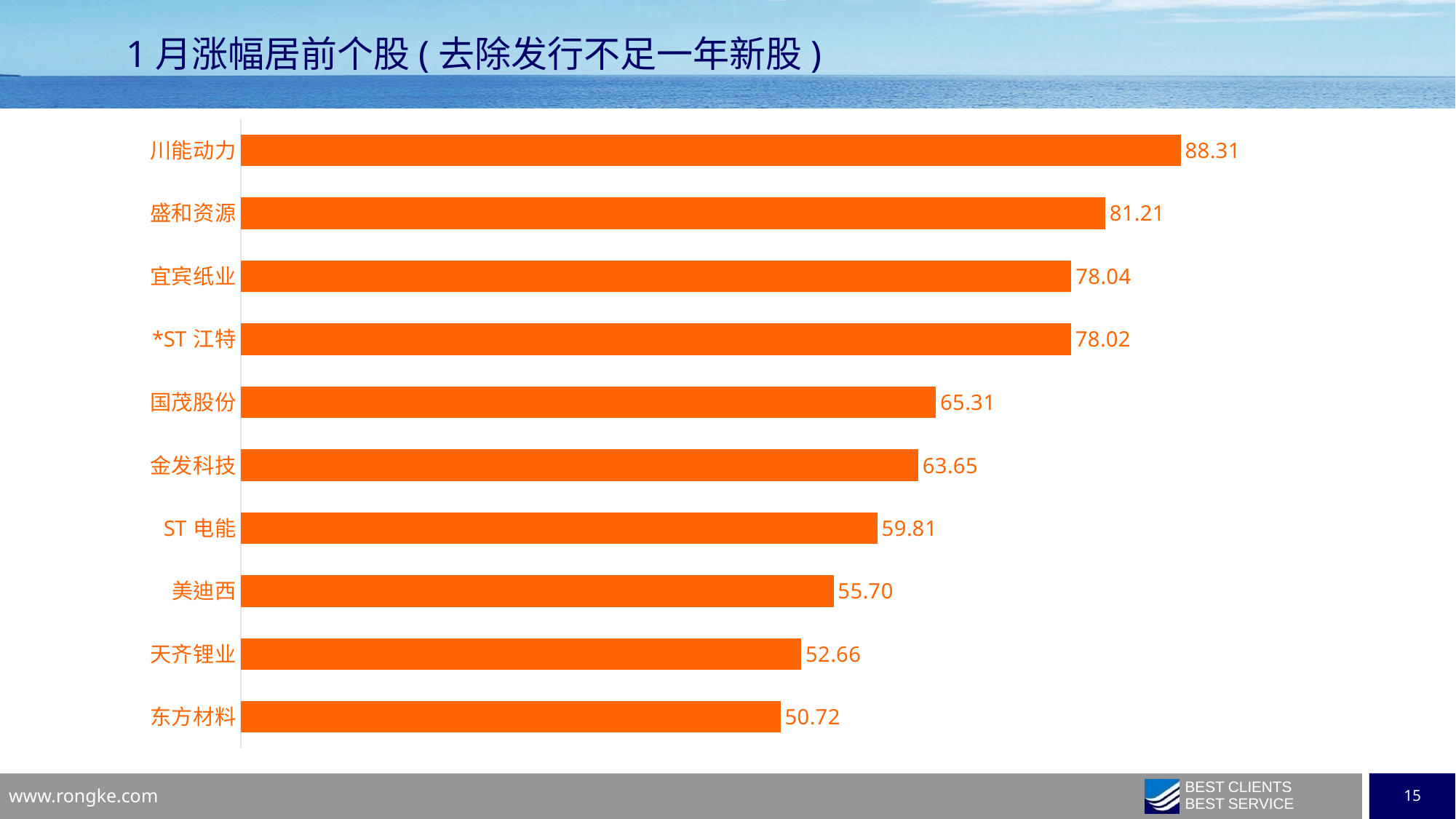
What is the value for 金发科技? 63.65 Which stock has the highest value? 川能动力 How many stocks are shown in the chart? 10 What kind of chart is shown on the slide? Bar chart What is the value for 川能动力? 88.31 What is the difference between the values for 川能动力 and 东方材料? 37.59 What is the difference between the values for 川能动力 and 盛和资源? 7.10 What is the value for 天齐锂业? 52.66 Which is larger, the value for 国茂股份 or the value for 美迪西? 国茂股份 What is the value for ST 电能? 59.81 Which stock has the lowest value? 东方材料 What is the title of the slide? 1 月涨幅居前个股（去除发行不足一年新股）